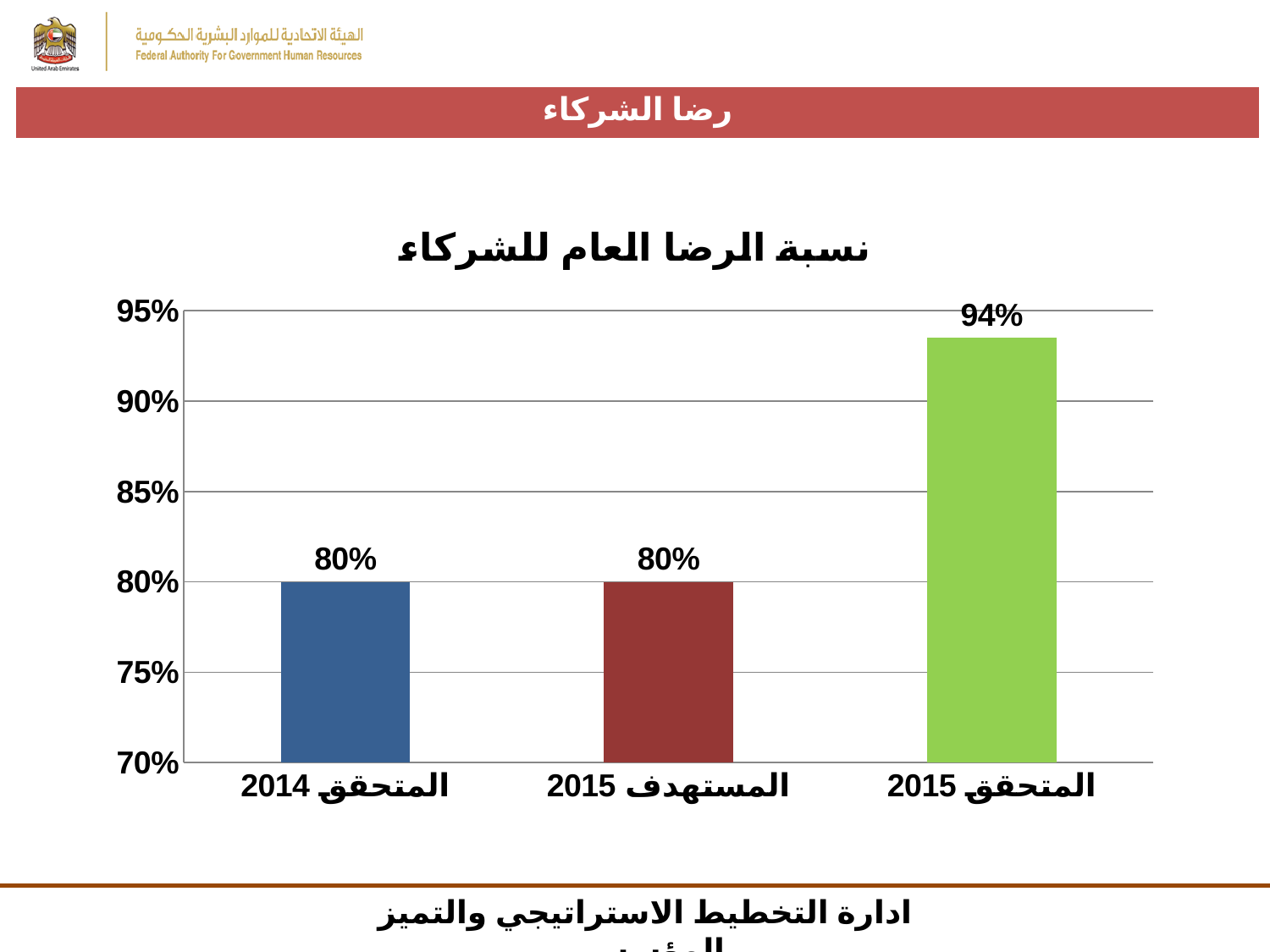
Which is larger, the value for المتحقق 2015 or the value for المتحقق 2014? المتحقق 2015 What is the difference between المتحقق 2015 and المتحقق 2014? 14% What is the value for المستهدف 2015? 80% Is the value for المستهدف 2015 greater or less than 85%? less What is the difference between المتحقق 2015 and المستهدف 2015? 14% What is the title of the chart? نسبة الرضا العام للشركاء What is the value for المتحقق 2014? 80% Which category has the highest value? المتحقق 2015 What kind of chart is shown on the slide? Bar chart Is the value for المتحقق 2015 greater or less than 90%? greater What is the value for المتحقق 2015? 94% How many categories are shown in the chart? 3